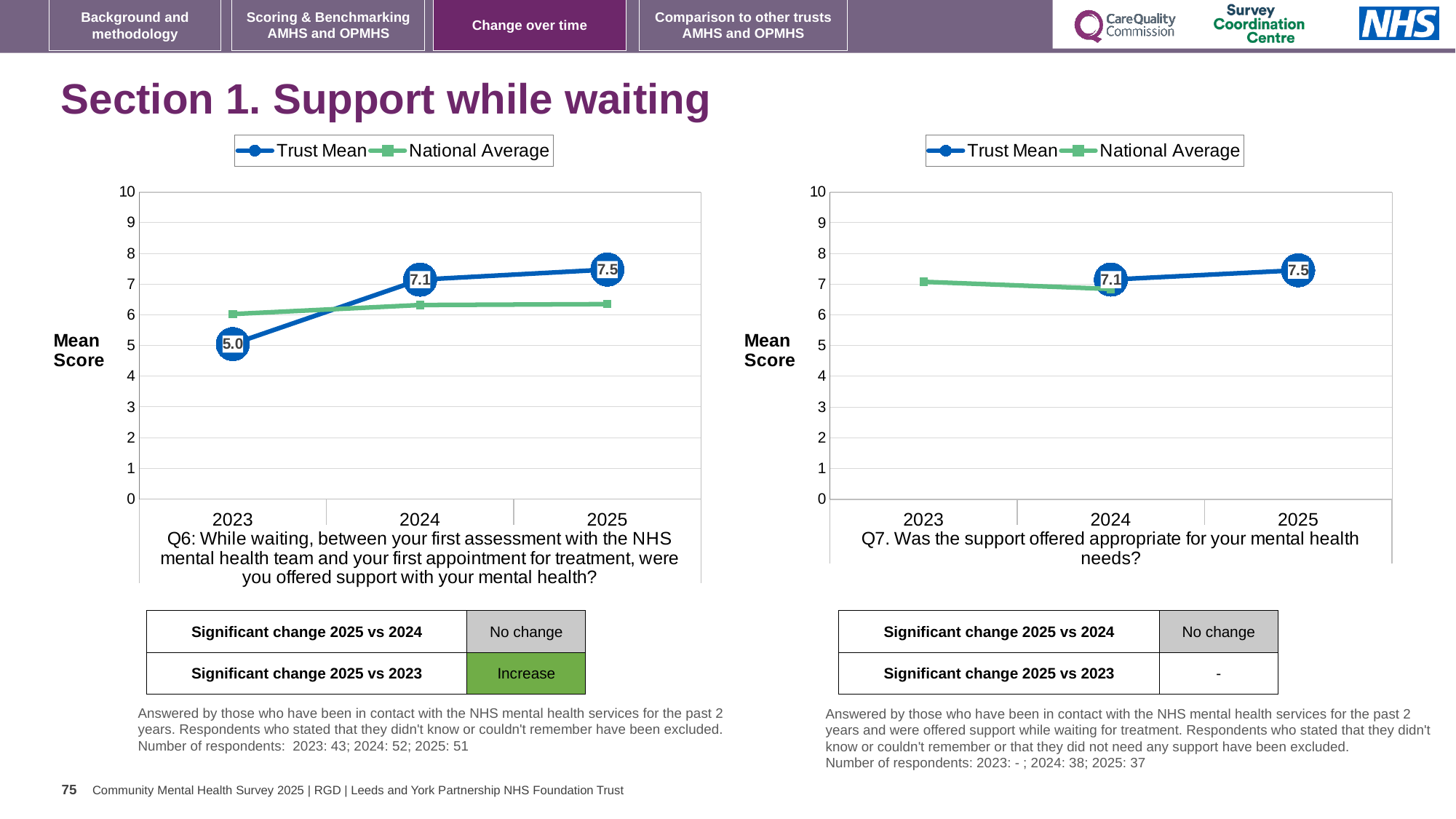
In the Q6 chart on the left, which year has the lowest Trust Mean score? 2023 How many series does the legend of the Q7 chart on the right list? 2 What type of chart is used for Q6 on the left? Line chart In the Q7 chart on the right, what is the difference between the Trust Mean in 2025 and in 2024? 0.4 In the Q6 chart on the left, does the Trust Mean rise or fall from 2023 to 2025? rise In the Q6 chart on the left, which year has the highest Trust Mean score? 2025 In the Q6 chart on the left, by how much did the Trust Mean rise from 2023 to 2025? 2.5 In the Q6 chart on the left, is the National Average for 2023 greater or less than 7? less In the Q6 chart on the left, what is the Trust Mean score for 2023? 5.0 In the Q6 chart on the left, what is the Trust Mean score for 2025? 7.5 In the Q6 chart on the left, is the Trust Mean or the National Average higher in 2023? National Average In the Q7 chart on the right, what is the Trust Mean score for 2024? 7.1